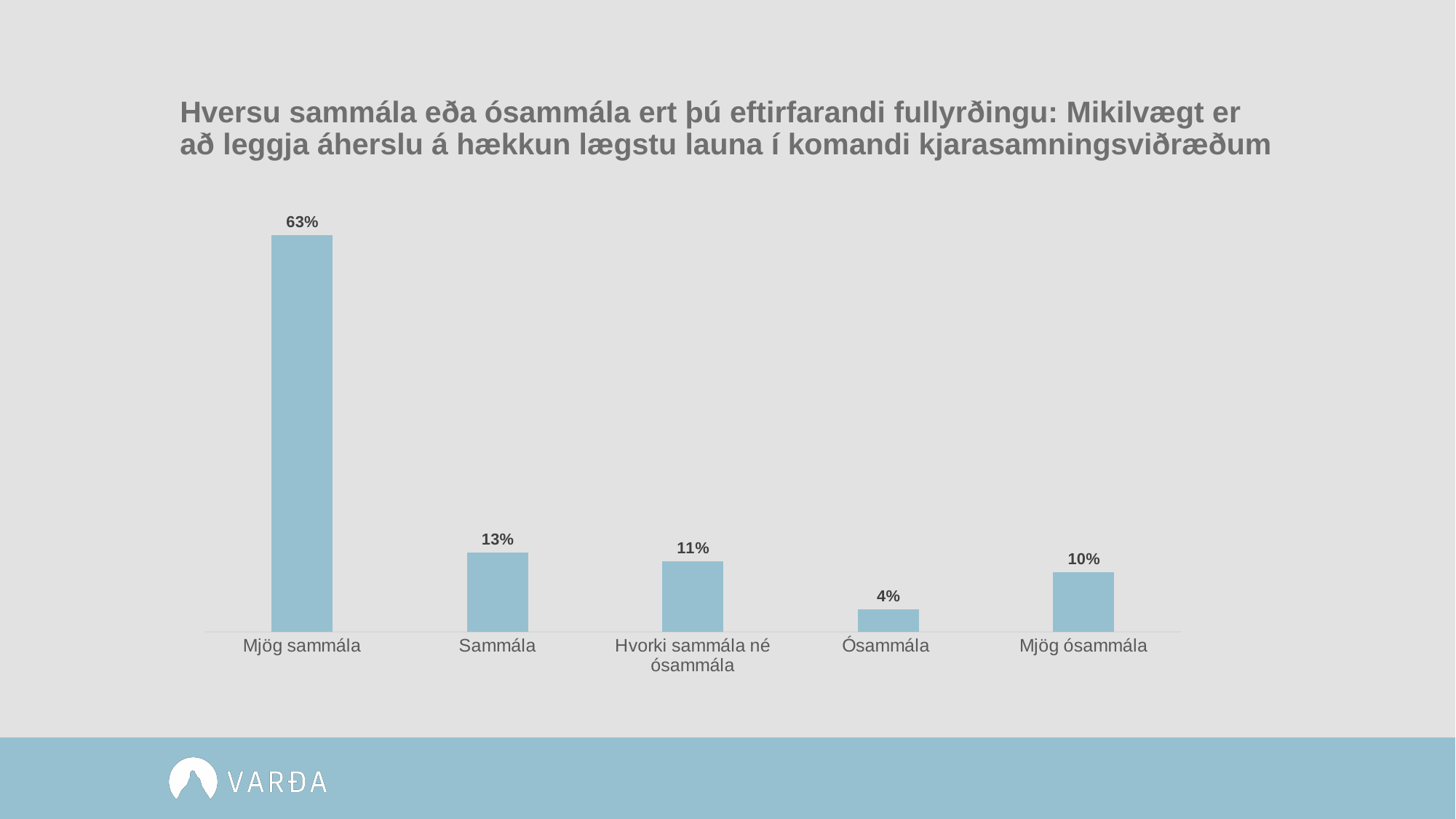
How many categories are shown on the chart? 5 Which category has the lowest value? Ósammála What kind of chart is shown on the slide? Bar chart What is the value for Mjög ósammála? 10% What is the difference between the values for Mjög sammála and Sammála? 50% What is the value for Ósammála? 4% What is the difference between the values for Hvorki sammála né ósammála and Ósammála? 7% What is the value for Hvorki sammála né ósammála? 11% Which category has the highest value? Mjög sammála Which is larger, the value for Sammála or the value for Mjög ósammála? Sammála What is the value for Mjög sammála? 63% What is the value for Sammála? 13%